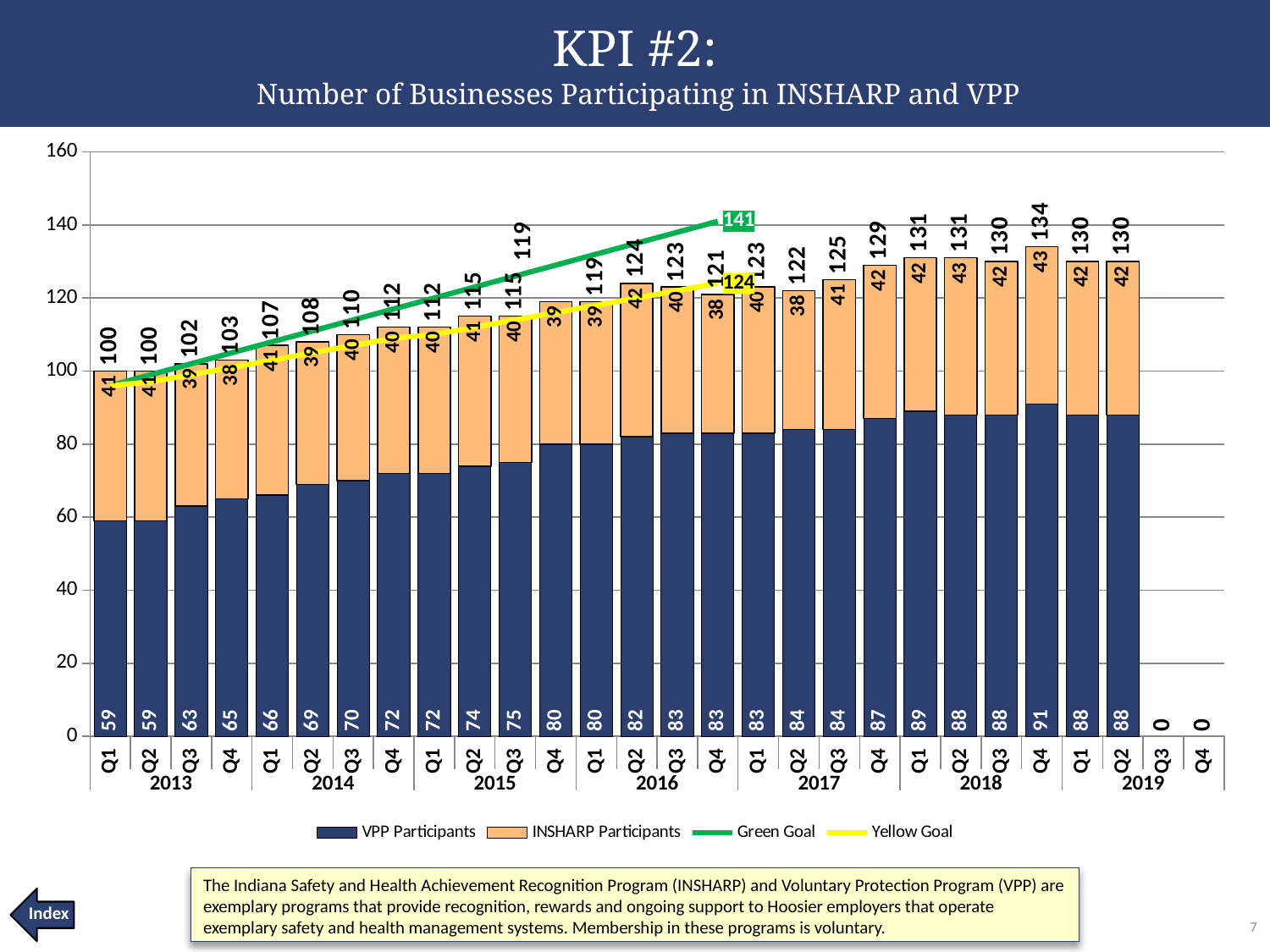
Do the VPP Participants values generally rise or fall from 2013 to 2018? rise What value does the Green Goal line reach at its end? 141 What kind of chart is shown on the slide? combination bar and line chart How many INSHARP Participants were there in Q4 2018? 43 What is the total number of participating businesses in Q1 2016? 119 Which quarter had more VPP Participants, Q4 2018 or Q1 2019? Q4 2018 What is the difference in VPP Participants between Q2 2019 and Q1 2013? 29 How many VPP Participants were there in Q1 2013? 59 How many series does the legend list? 4 What is the total number of businesses (VPP plus INSHARP) for Q4 2018? 134 What value does the Yellow Goal line reach at its end? 124 Which quarter has the highest total number of participating businesses? Q4 2018